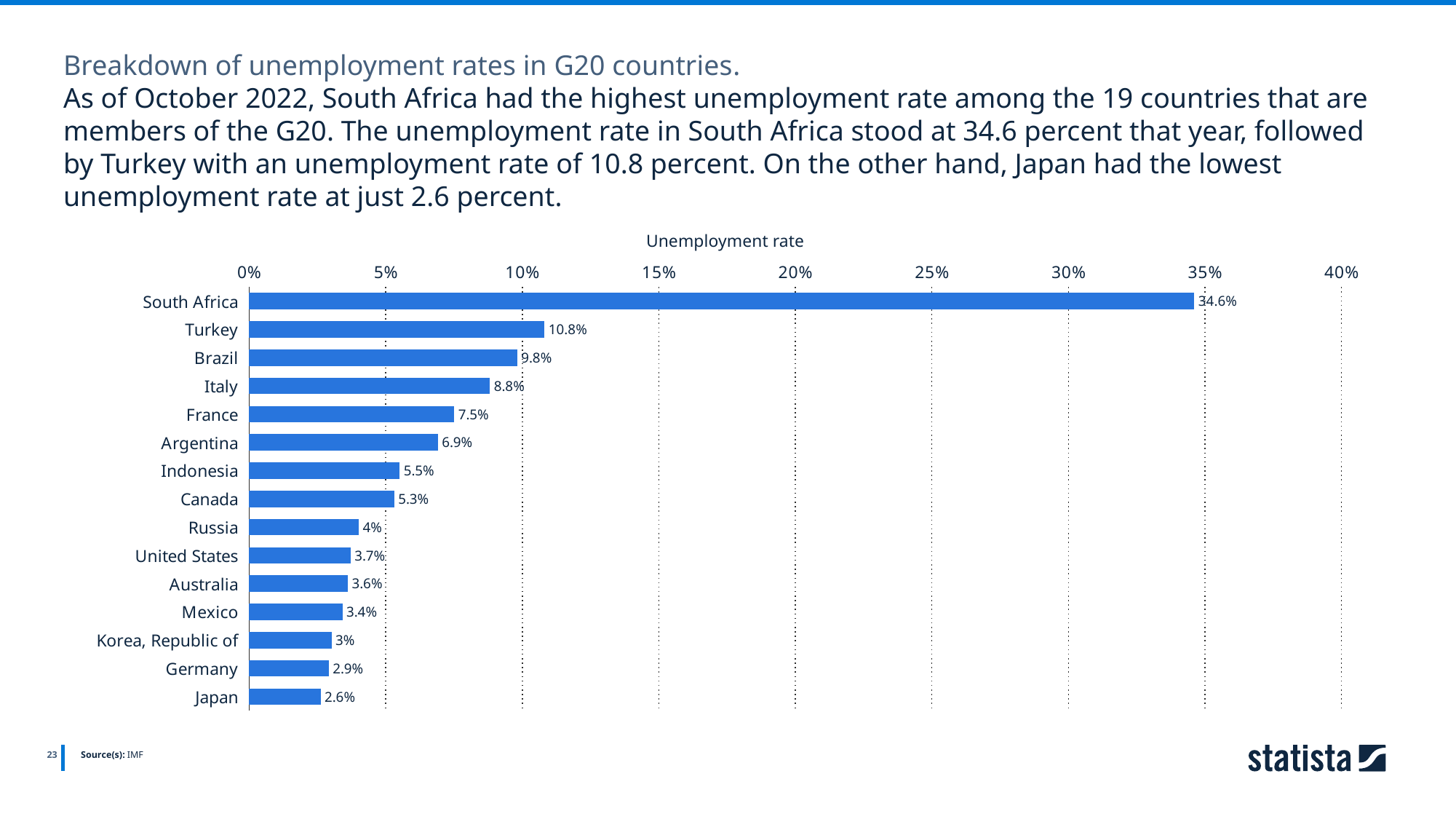
What is the unemployment rate for Indonesia? 5.5% Which country has the lowest unemployment rate? Japan What is the unemployment rate for Germany? 2.9% What is the difference between the unemployment rates of South Africa and Turkey? 23.8% How many countries are shown in the chart? 15 Is the value for Turkey greater or less than 10%? greater What is the unemployment rate for Brazil? 9.8% What is the title of the chart? Unemployment rate What kind of chart is shown on the slide? bar chart Which country has the highest unemployment rate? South Africa Which has a higher unemployment rate, Italy or Canada? Italy What is the difference between the unemployment rates of France and Argentina? 0.6%